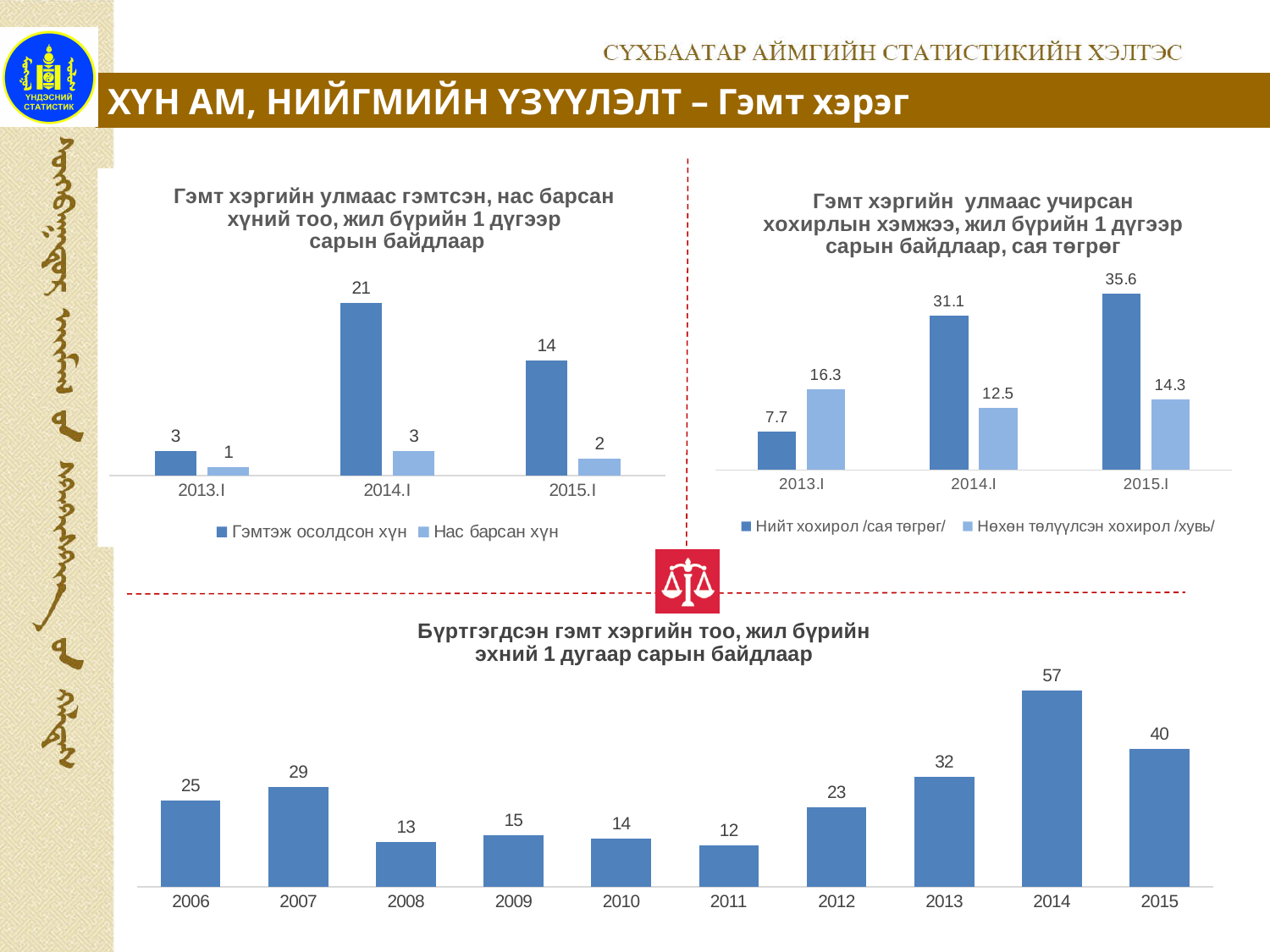
In the top-right chart (Гэмт хэргийн улмаас учирсан хохирлын хэмжээ), what is the value for Нийт хохирол /сая төгрөг/ in 2015.I? 35.6 In the top-right chart (Гэмт хэргийн улмаас учирсан хохирлын хэмжээ), what is the difference between Нийт хохирол /сая төгрөг/ in 2014.I and 2013.I? 23.4 How many series does the legend of the top-left chart (Гэмт хэргийн улмаас гэмтсэн, нас барсан хүний тоо) list? 2 What type of chart is the bottom chart (Бүртгэгдсэн гэмт хэргийн тоо)? Bar chart In the top-left chart (Гэмт хэргийн улмаас гэмтсэн, нас барсан хүний тоо), what is the value for Гэмтэж осолдсон хүн in 2014.I? 21 In the bottom chart (Бүртгэгдсэн гэмт хэргийн тоо), what is the difference between the values for 2014 and 2015? 17 How many years are shown on the x axis of the bottom chart (Бүртгэгдсэн гэмт хэргийн тоо)? 10 In the bottom chart (Бүртгэгдсэн гэмт хэргийн тоо), which year has the lowest value? 2011 In the top-left chart (Гэмт хэргийн улмаас гэмтсэн, нас барсан хүний тоо), what is the value for Нас барсан хүн in 2015.I? 2 In the bottom chart (Бүртгэгдсэн гэмт хэргийн тоо), what is the value for 2014? 57 In the bottom chart (Бүртгэгдсэн гэмт хэргийн тоо), which year has the highest value? 2014 In the top-right chart (Гэмт хэргийн улмаас учирсан хохирлын хэмжээ), which is larger in 2013.I: Нийт хохирол /сая төгрөг/ or Нөхөн төлүүлсэн хохирол /хувь/? Нөхөн төлүүлсэн хохирол /хувь/